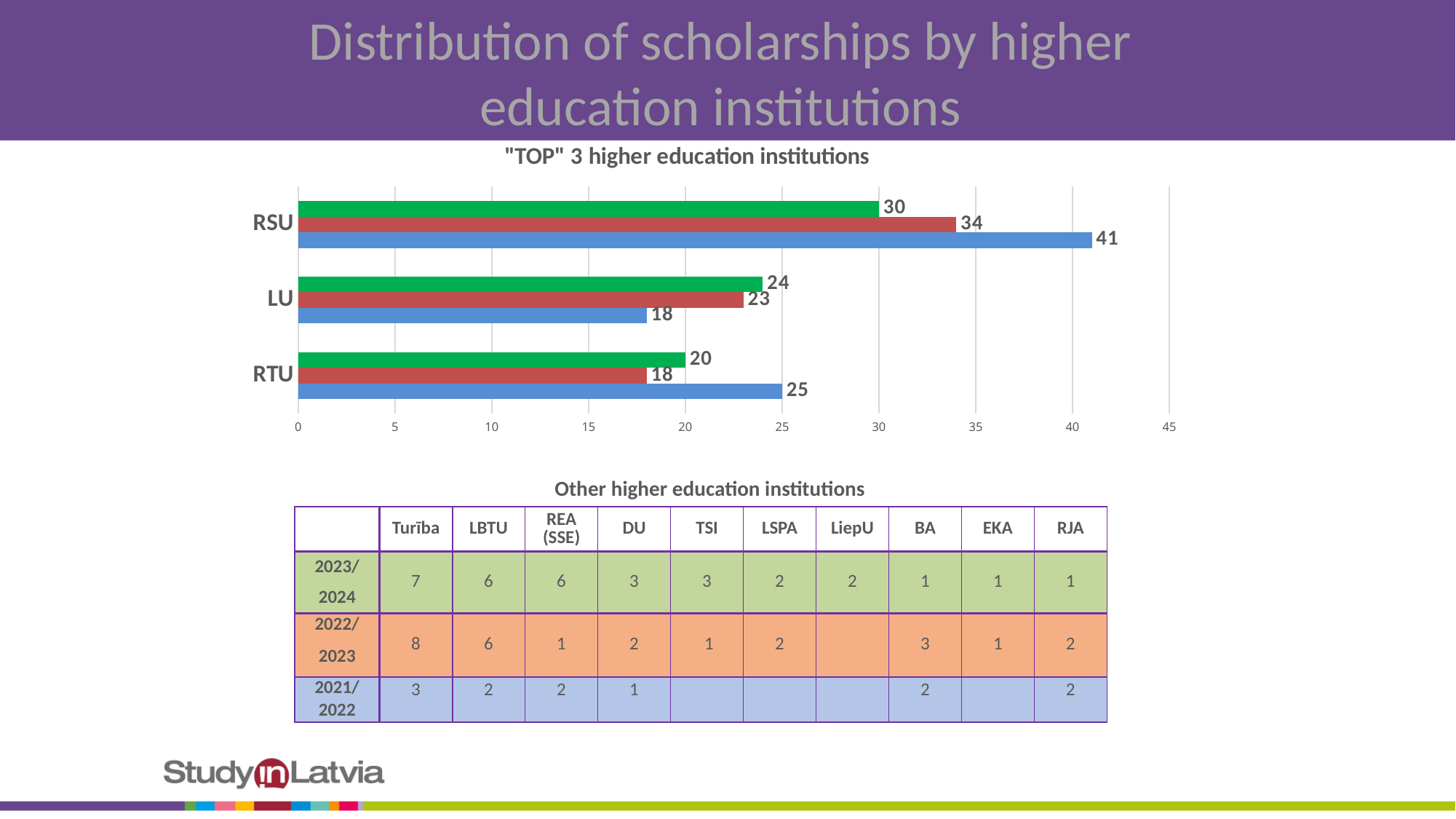
What is the value of the blue bar for RSU in the "TOP" 3 higher education institutions chart? 41 What is the difference between the blue bar for RSU and the blue bar for RTU in the "TOP" 3 higher education institutions chart? 16 In the "TOP" 3 higher education institutions chart, which is larger for LU: the green bar or the blue bar? the green bar In the "TOP" 3 higher education institutions chart, is the red bar for RSU greater or less than 30? greater How many institutions are shown in the "TOP" 3 higher education institutions chart? 3 What is the title of the chart on the slide? "TOP" 3 higher education institutions Which institution has the highest value among the blue bars in the "TOP" 3 higher education institutions chart? RSU What is the value of the red bar for LU in the "TOP" 3 higher education institutions chart? 23 What type of chart is the "TOP" 3 higher education institutions chart? bar chart What is the difference between the red bar and the green bar for RSU in the "TOP" 3 higher education institutions chart? 4 Which institution has the lowest value among the green bars in the "TOP" 3 higher education institutions chart? RTU What is the value of the green bar for RTU in the "TOP" 3 higher education institutions chart? 20